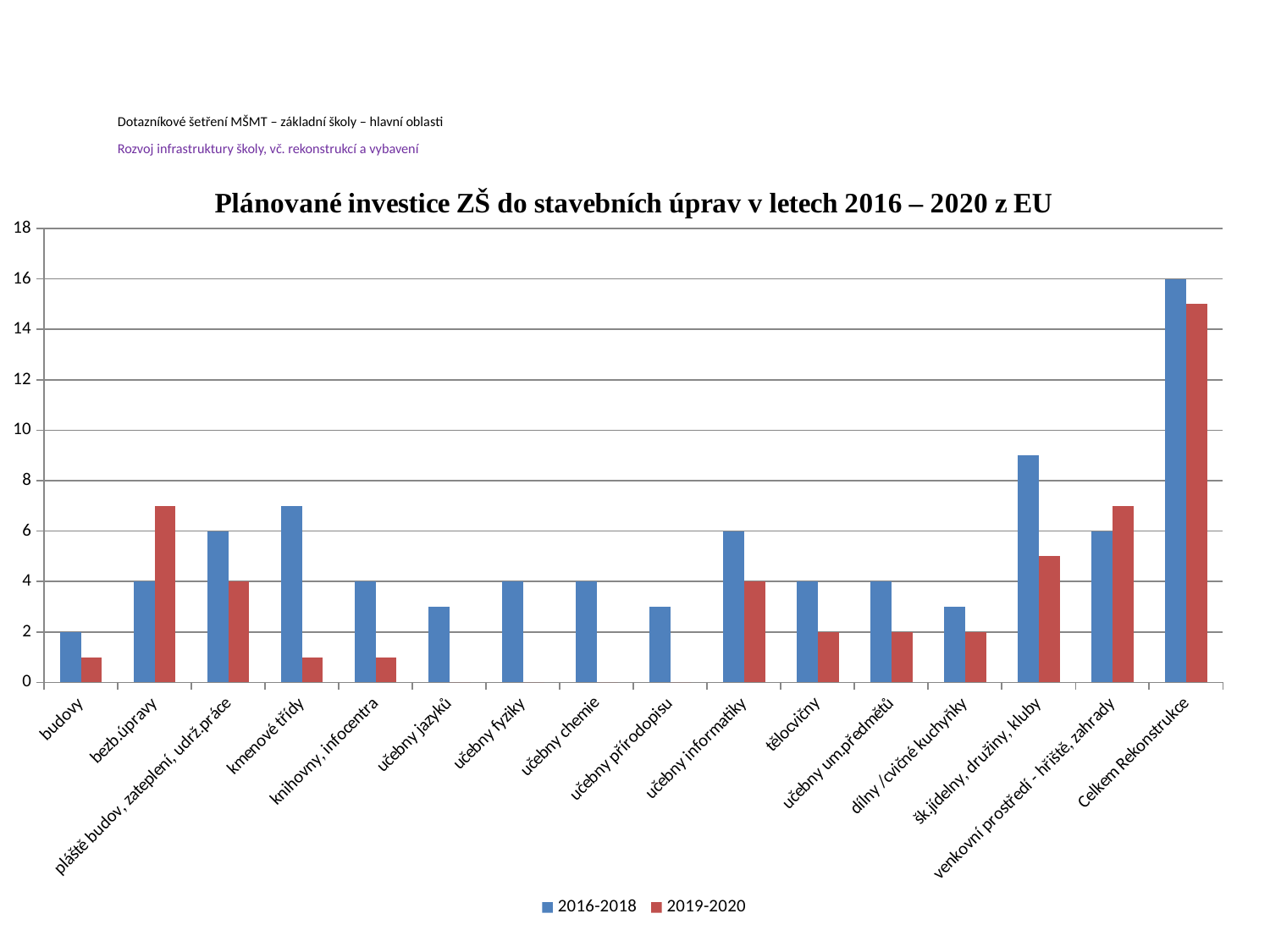
Which is larger for bezb.úpravy: the 2016-2018 value or the 2019-2020 value? 2019-2020 How many categories are shown on the x axis? 16 What is the title of the chart? Plánované investice ZŠ do stavebních úprav v letech 2016 – 2020 z EU What is the difference between the 2016-2018 and 2019-2020 values for učebny informatiky? 2 What kind of chart is shown on the slide? bar chart What is the value for tělocvičny in the 2019-2020 series? 2 Is the value for kmenové třídy in the 2019-2020 series greater or less than 2? less Is the value for šk.jídelny, družiny, kluby in the 2016-2018 series greater or less than 8? greater What is the value for Celkem Rekonstrukce in the 2016-2018 series? 16 Which category has the highest value in the 2016-2018 series? Celkem Rekonstrukce What is the value for učebny informatiky in the 2016-2018 series? 6 How many series does the legend list? 2